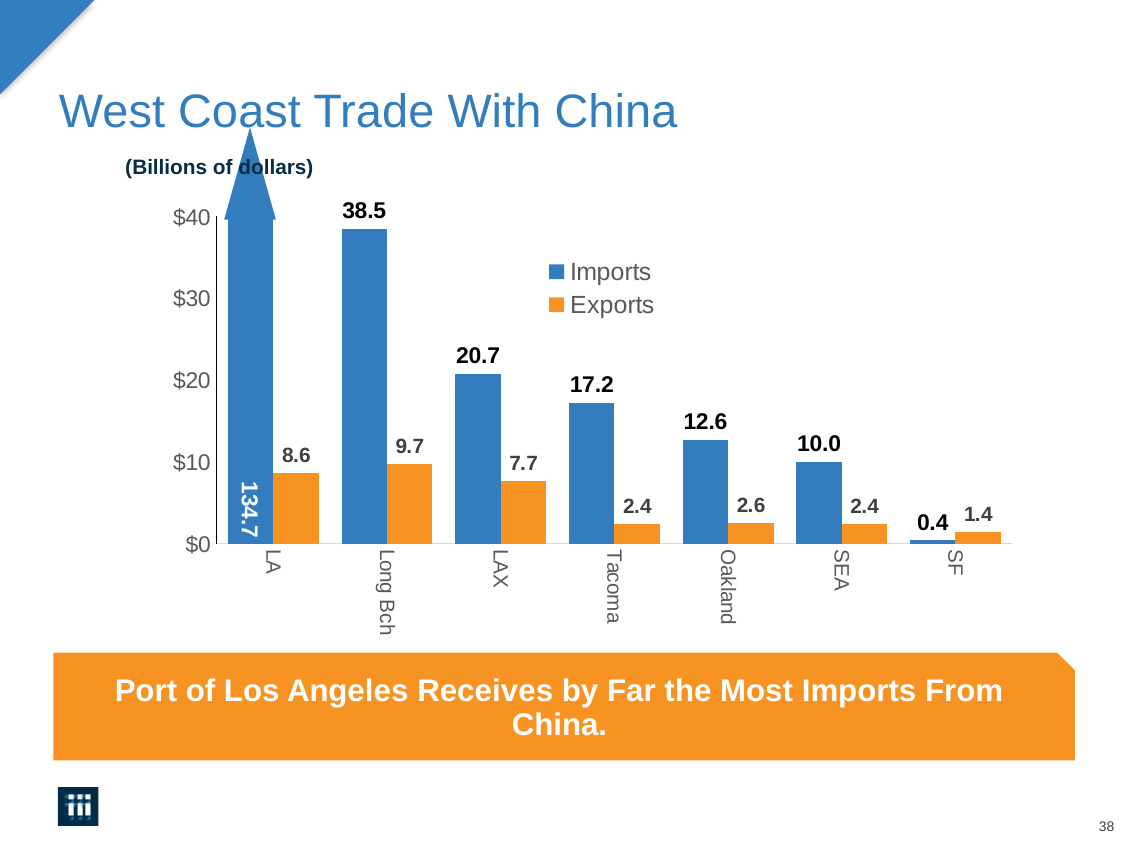
How many series does the legend list? 2 What is the Imports value for LA? 134.7 What unit is stated for the values in the chart? Billions of dollars What is the Exports value for LAX? 7.7 What kind of chart is shown on the slide? Bar chart How many ports are shown on the x axis? 7 Which is larger for SF, Imports or Exports? Exports Is the Imports value for Oakland greater or less than $10? greater Which port has the highest Imports value? LA What is the Imports value for Long Bch? 38.5 What is the difference between Imports and Exports for Tacoma? 14.8 Which port has the lowest Imports value? SF